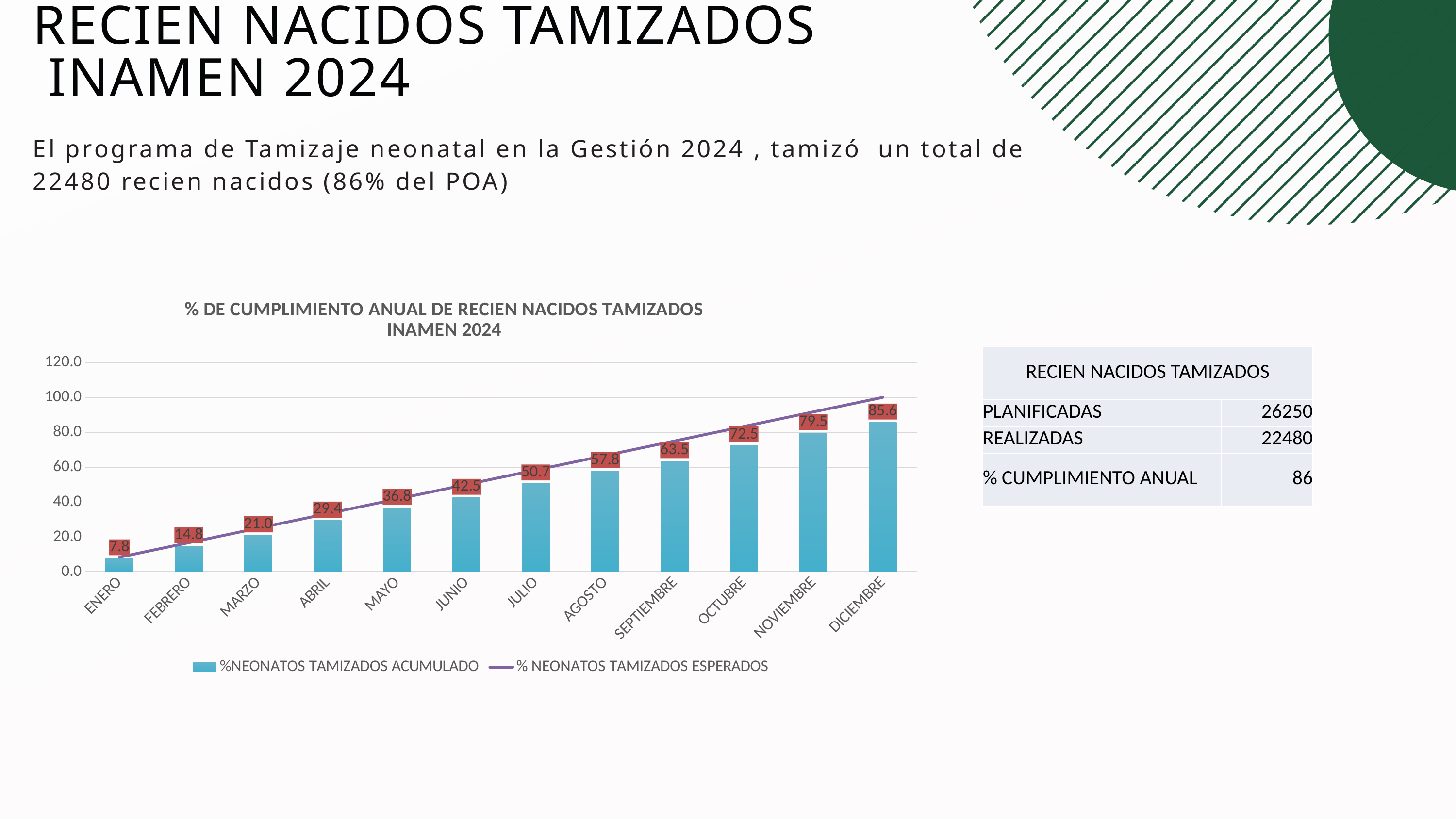
Do the %NEONATOS TAMIZADOS ACUMULADO values rise or fall from ENERO to DICIEMBRE? Rise What is the value of %NEONATOS TAMIZADOS ACUMULADO for DICIEMBRE? 85.6 Which month has the lowest value of %NEONATOS TAMIZADOS ACUMULADO? ENERO How many months are shown on the x axis of the chart? 12 Which is larger, the %NEONATOS TAMIZADOS ACUMULADO value for AGOSTO or for MAYO? AGOSTO Is the % NEONATOS TAMIZADOS ESPERADOS line value for DICIEMBRE greater or less than 80.0? greater What is the value of %NEONATOS TAMIZADOS ACUMULADO for JULIO? 50.7 How many series does the chart legend list? 2 What is the value of %NEONATOS TAMIZADOS ACUMULADO for ENERO? 7.8 What is the difference between the %NEONATOS TAMIZADOS ACUMULADO values for DICIEMBRE and NOVIEMBRE? 6.1 What kind of chart is used to show %NEONATOS TAMIZADOS ACUMULADO? Bar chart Which month has the highest value of %NEONATOS TAMIZADOS ACUMULADO? DICIEMBRE